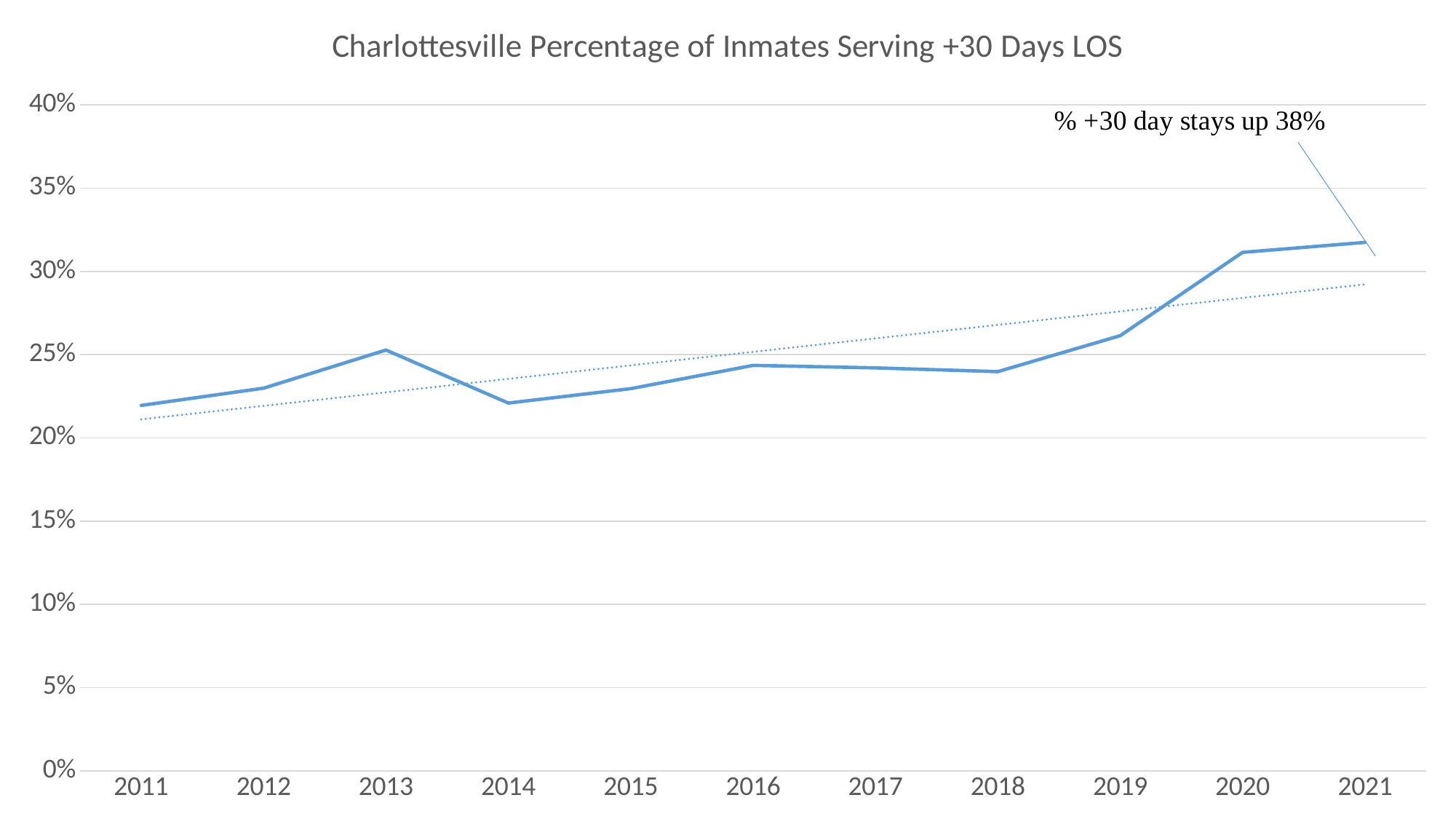
What does the annotation text on the chart say? % +30 day stays up 38% Which year has the larger value, 2013 or 2014? 2013 Is the value for 2020 greater or less than 30%? greater Overall, do the values rise or fall from 2011 to 2021? rise Is the value for 2018 greater or less than 25%? less Which year has the larger value, 2018 or 2020? 2020 Is the value for 2011 greater or less than 25%? less What kind of chart is shown on the slide? line chart How many years are plotted along the x axis? 11 What is the title of the chart? Charlottesville Percentage of Inmates Serving +30 Days LOS